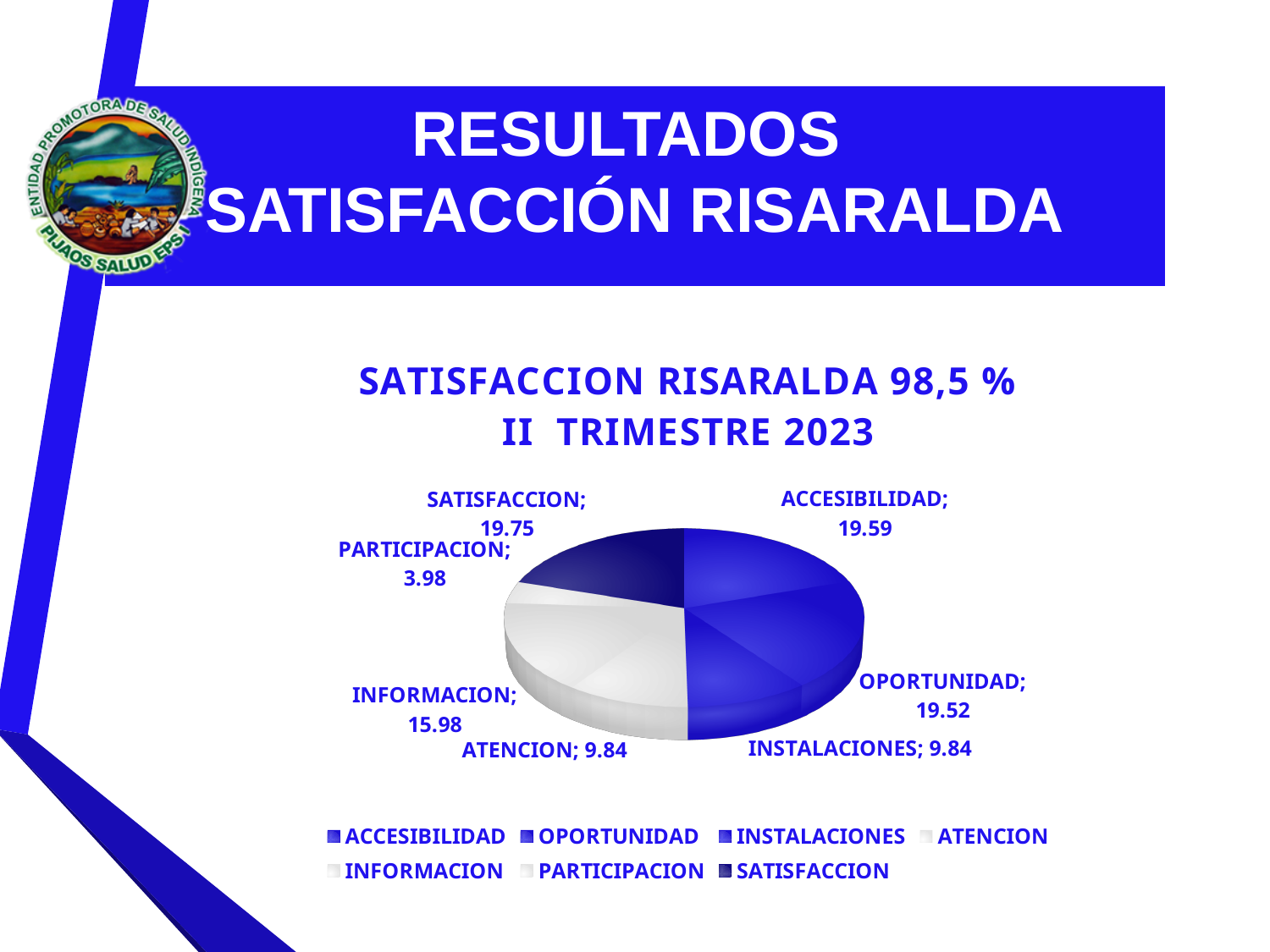
What is the difference between the values for INFORMACION and ATENCION? 6.14 What type of chart is shown on the slide? Pie chart What is the value for PARTICIPACION in the pie chart? 3.98 How many categories (slices) does the pie chart have? 7 What is the value for ACCESIBILIDAD in the pie chart? 19.59 What is the title of the chart? SATISFACCION RISARALDA 98,5 % II TRIMESTRE 2023 Which category has the smallest value in the pie chart? PARTICIPACION Which category has the largest value in the pie chart? SATISFACCION What is the value for INSTALACIONES in the pie chart? 9.84 What is the difference between the values for SATISFACCION and PARTICIPACION? 15.77 What is the value for INFORMACION in the pie chart? 15.98 Which is larger, the value for OPORTUNIDAD or the value for INFORMACION? OPORTUNIDAD